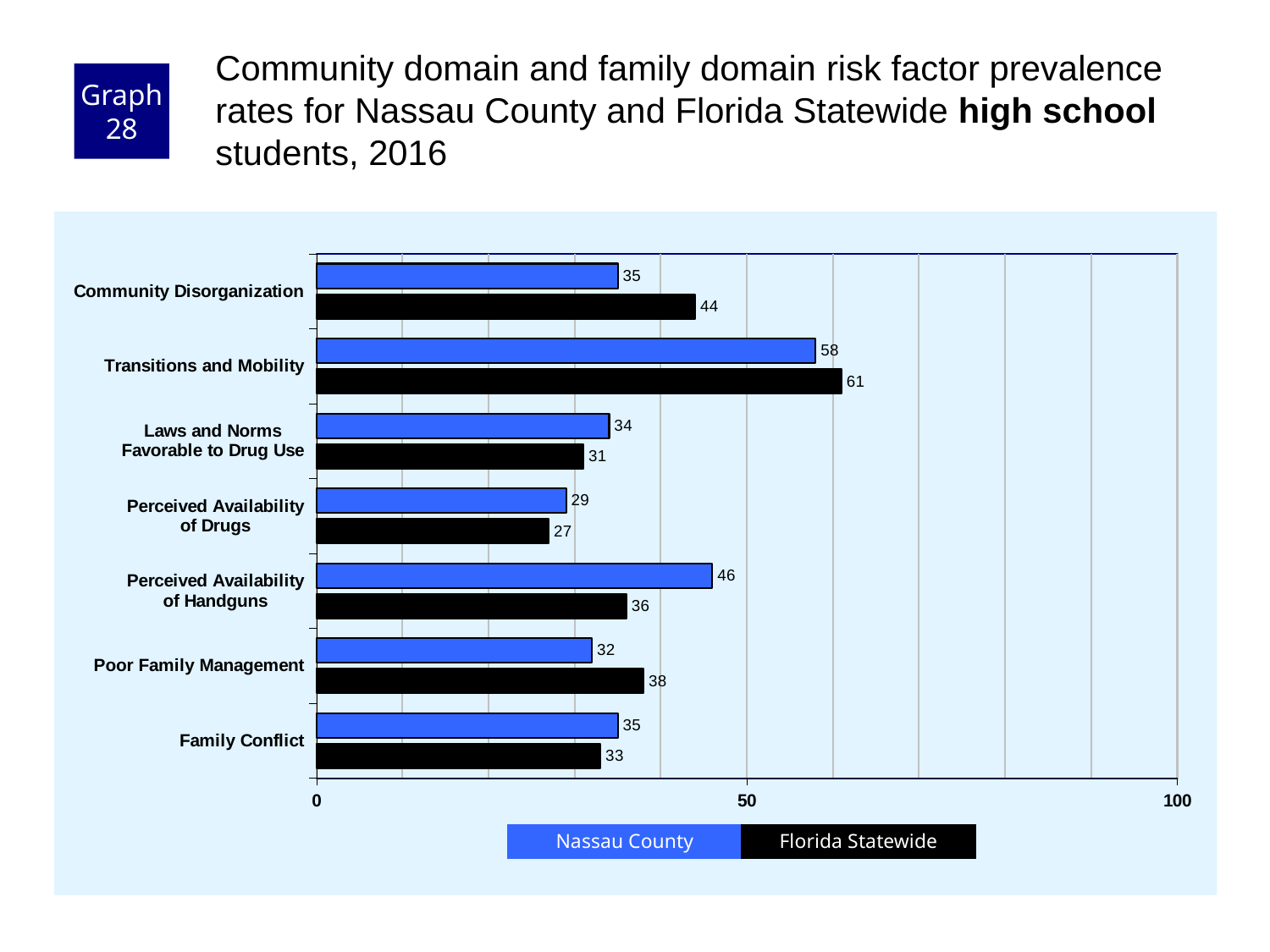
What is the difference between the Florida Statewide and Nassau County values for Community Disorganization? 9 Which risk factor has the lowest Nassau County value? Perceived Availability of Drugs What is the Florida Statewide value for Perceived Availability of Handguns? 36 Is the Florida Statewide value for Transitions and Mobility greater or less than 50? greater For Perceived Availability of Handguns, which is larger: the Nassau County value or the Florida Statewide value? Nassau County What is the Nassau County value for Transitions and Mobility? 58 How many risk factor categories are shown on the chart? 7 What kind of chart is shown on the slide? Bar chart Which series is shown in black in the legend? Florida Statewide Which risk factor has the highest Florida Statewide value? Transitions and Mobility How many series does the legend list? 2 What is the Florida Statewide value for Poor Family Management? 38